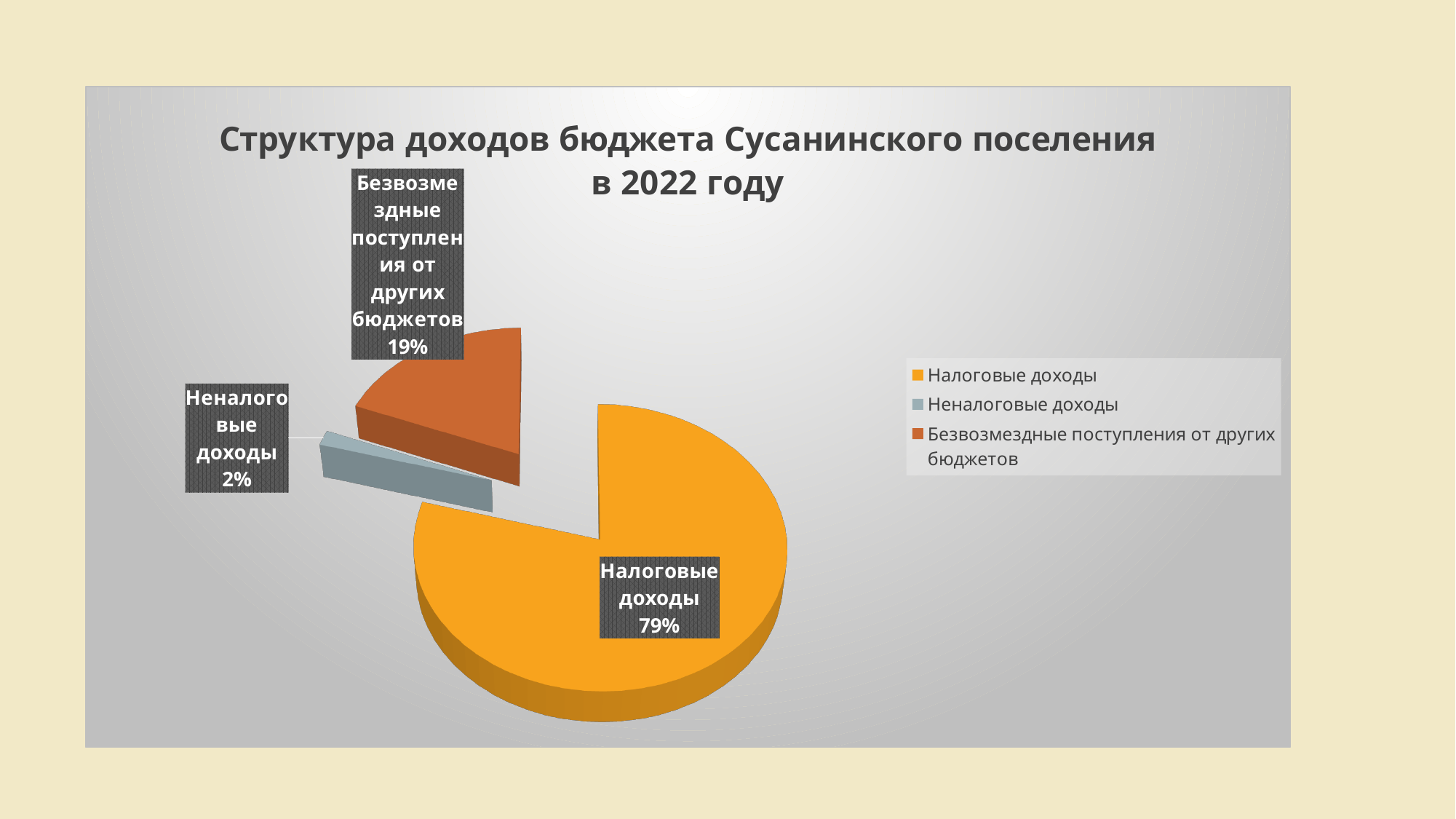
What share of the pie does Неналоговые доходы represent? 2% What colour is the slice for Налоговые доходы? Orange (yellow-orange) What is the title of the chart? Структура доходов бюджета Сусанинского поселения в 2022 году What share of the pie does Налоговые доходы represent? 79% Which category has the smallest share of the pie? Неналоговые доходы What is the difference in percentage points between Налоговые доходы and Безвозмездные поступления от других бюджетов? 60 Which category has the largest share of the pie? Налоговые доходы Which is larger: the share of Неналоговые доходы or the share of Безвозмездные поступления от других бюджетов? Безвозмездные поступления от других бюджетов How many categories (slices) does the pie chart have? 3 What kind of chart is shown on the slide? Pie chart What is the difference in percentage points between Безвозмездные поступления от других бюджетов and Неналоговые доходы? 17 What share of the pie does Безвозмездные поступления от других бюджетов represent? 19%